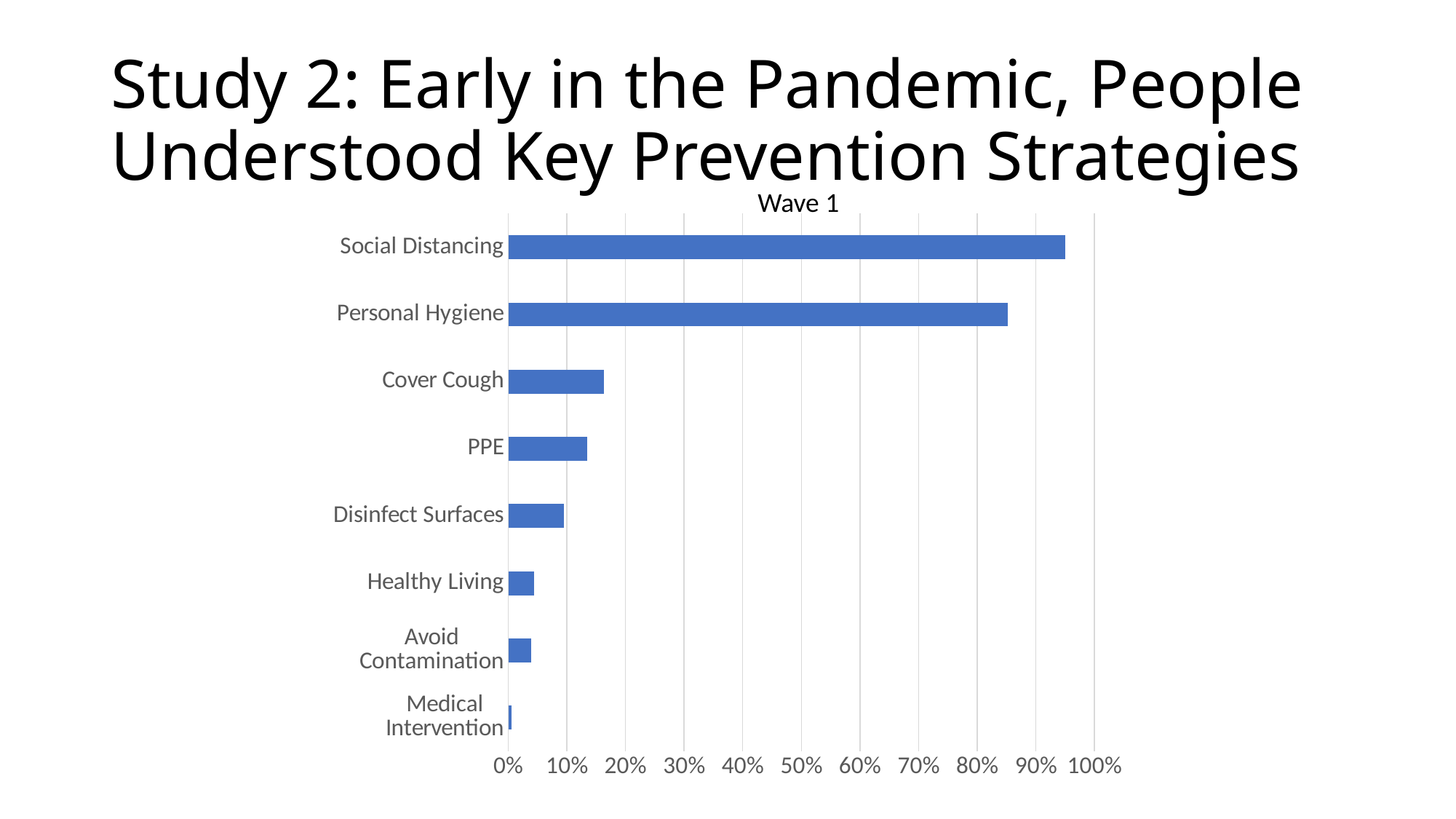
What kind of chart is shown on the slide? bar chart What is the title of the chart? Wave 1 Which has a larger value, Personal Hygiene or Social Distancing? Social Distancing Is the value for Cover Cough greater or less than 20%? less Is the value for PPE greater or less than 10%? greater Is the value for Personal Hygiene greater or less than 80%? greater Which category has the highest value? Social Distancing Which category has the lowest value? Medical Intervention Which has a larger value, Cover Cough or PPE? Cover Cough How many categories are plotted in the chart? 8